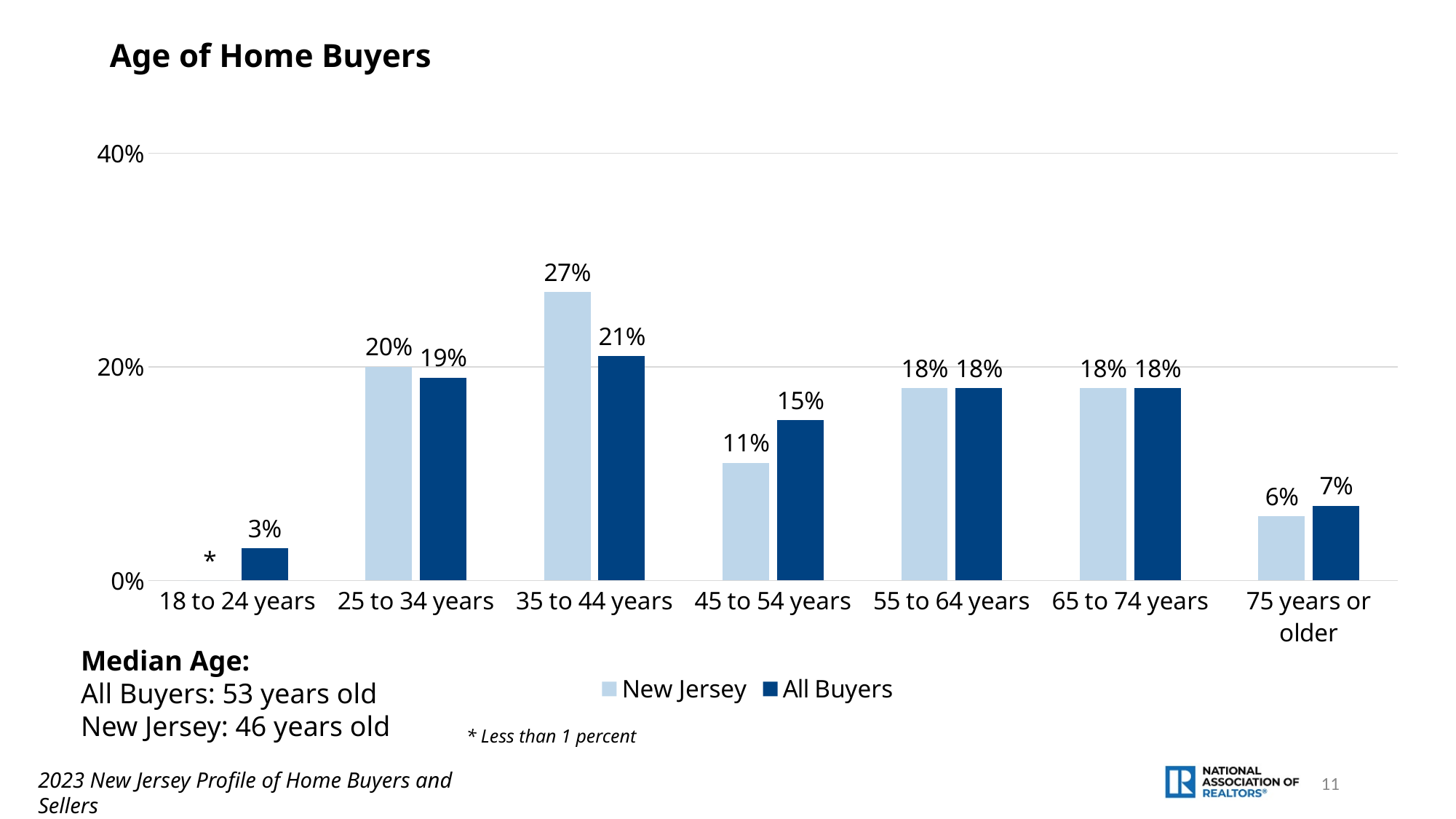
What is the difference between the New Jersey and All Buyers values for 35 to 44 years? 6% What is the value for All Buyers in the 18 to 24 years category? 3% What kind of chart is shown on the slide? bar chart For 45 to 54 years, which series has the larger value, New Jersey or All Buyers? All Buyers Which age group has the highest value for New Jersey? 35 to 44 years How many series does the legend list? 2 What percentage of New Jersey home buyers are 35 to 44 years old? 27% What percentage of All Buyers are 45 to 54 years old? 15% Is the New Jersey value for 25 to 34 years greater or less than 40%? less How many age categories are shown on the x axis? 7 What is the title of the chart? Age of Home Buyers Which age group has the lowest value for All Buyers? 18 to 24 years